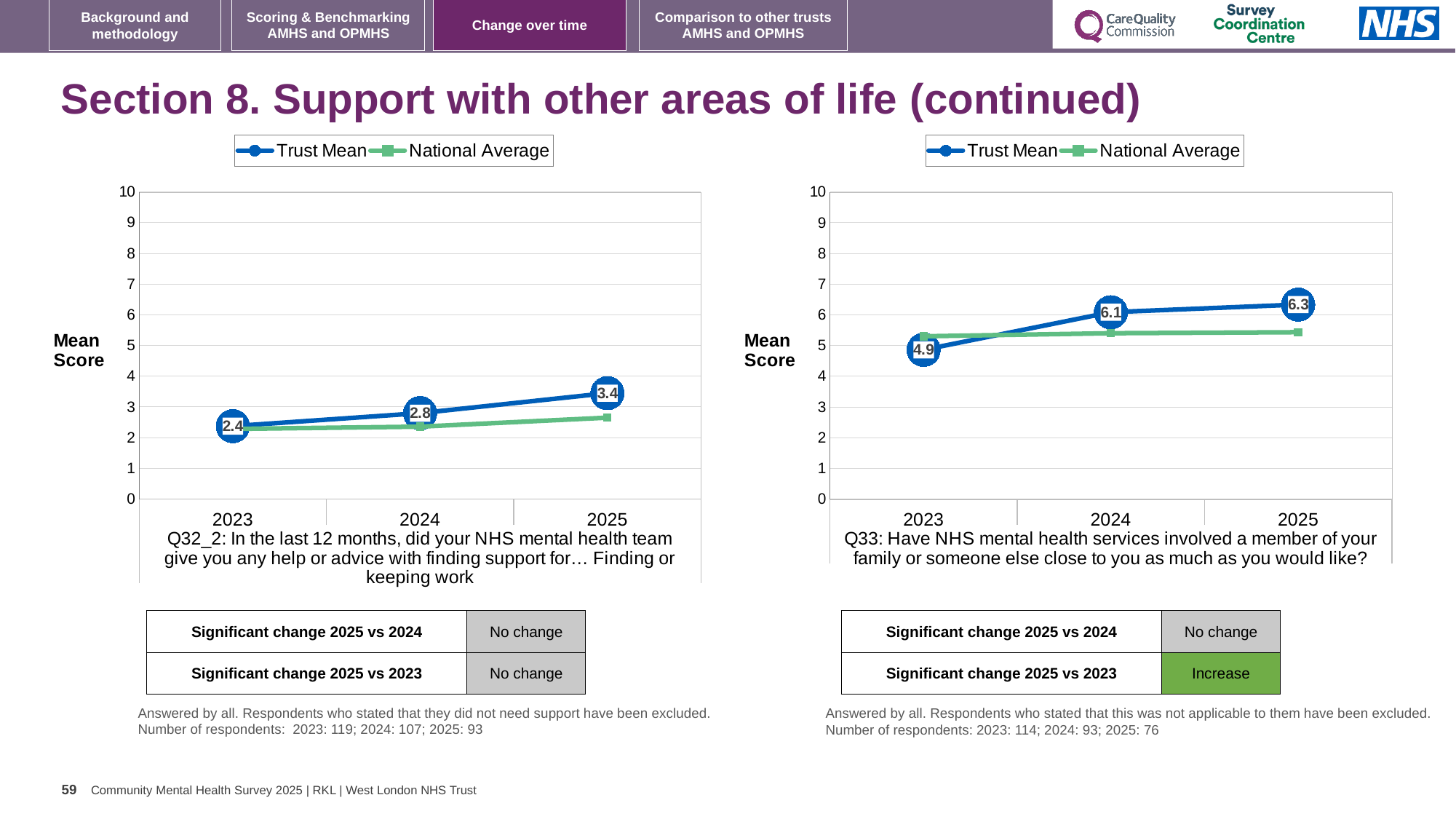
In the right chart (Q33), which year has the highest Trust Mean? 2025 In the left chart (Q32_2), which year has the lowest Trust Mean? 2023 In the left chart (Q32_2), what is the difference between the Trust Mean for 2024 and 2023? 0.4 In the right chart (Q33), what is the Trust Mean for 2024? 6.1 What kind of chart is the left chart (Q32_2)? Line chart In the right chart (Q33), is the Trust Mean for 2023 greater or less than 5? less In the left chart (Q32_2), what is the Trust Mean for 2023? 2.4 In the right chart (Q33), what is the difference between the Trust Mean for 2025 and 2023? 1.4 In the left chart (Q32_2), what is the Trust Mean for 2025? 3.4 In the left chart (Q32_2), how many years are plotted on the x axis? 3 In the right chart (Q33), is the National Average for 2025 greater or less than 6? less How many series does the legend of the right chart (Q33) list? 2